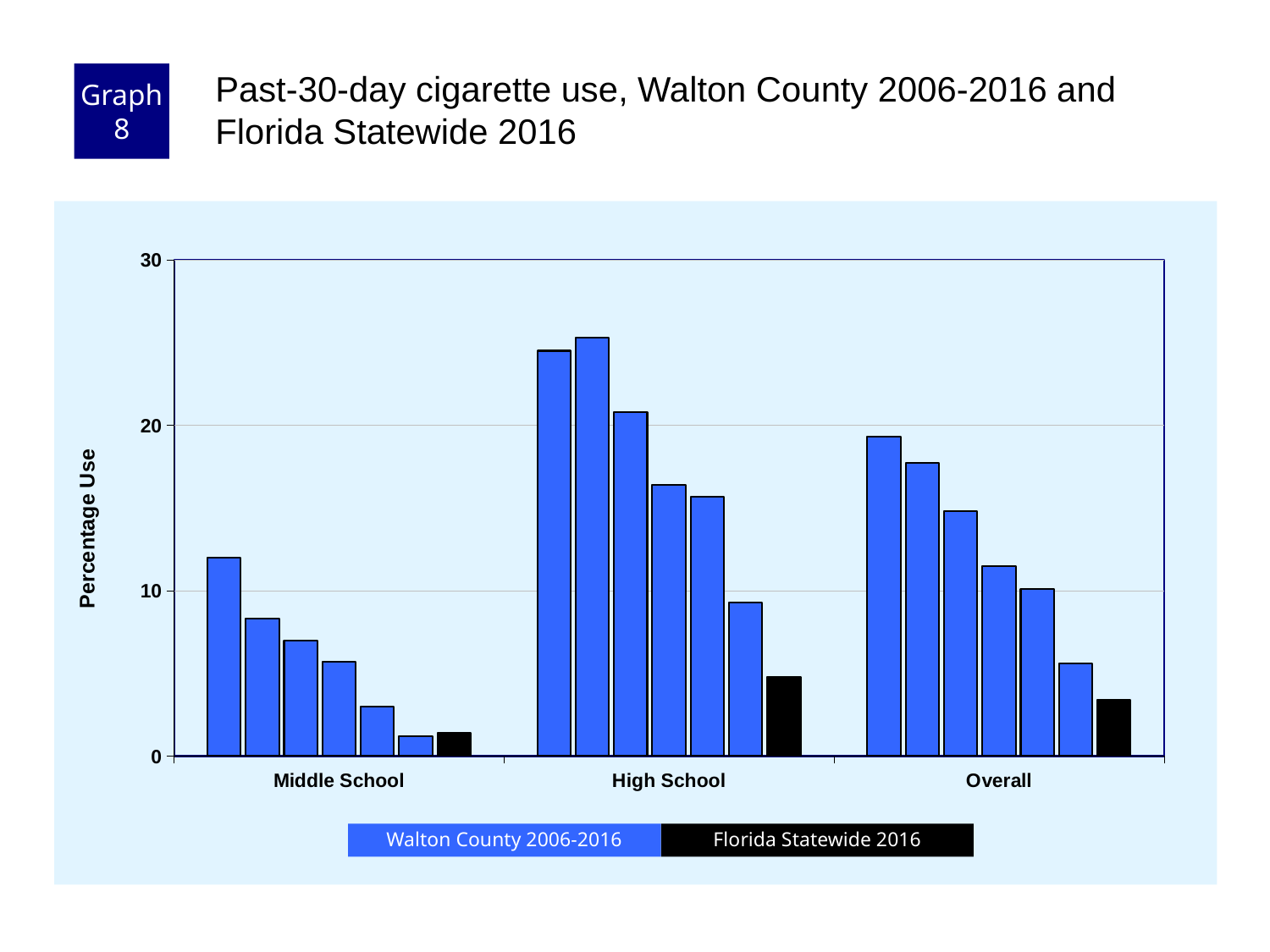
How many category groups are shown on the x axis? 3 How many series does the legend list? 2 What kind of chart is shown on the slide? bar chart What is the label on the y axis? Percentage Use What are the two legend entries? Walton County 2006-2016 and Florida Statewide 2016 Which category group contains the tallest bar on the chart? High School Within the Overall group, do the Walton County 2006-2016 bars rise or fall from left to right? fall Is the tallest Walton County 2006-2016 bar in the High School group greater or less than 20? greater Which is larger, the Florida Statewide 2016 value for High School or for Middle School? High School Is the Florida Statewide 2016 value for High School greater or less than 10? less Is the Florida Statewide 2016 value for Overall greater or less than 10? less How many Walton County 2006-2016 bars are shown in each category group? 6